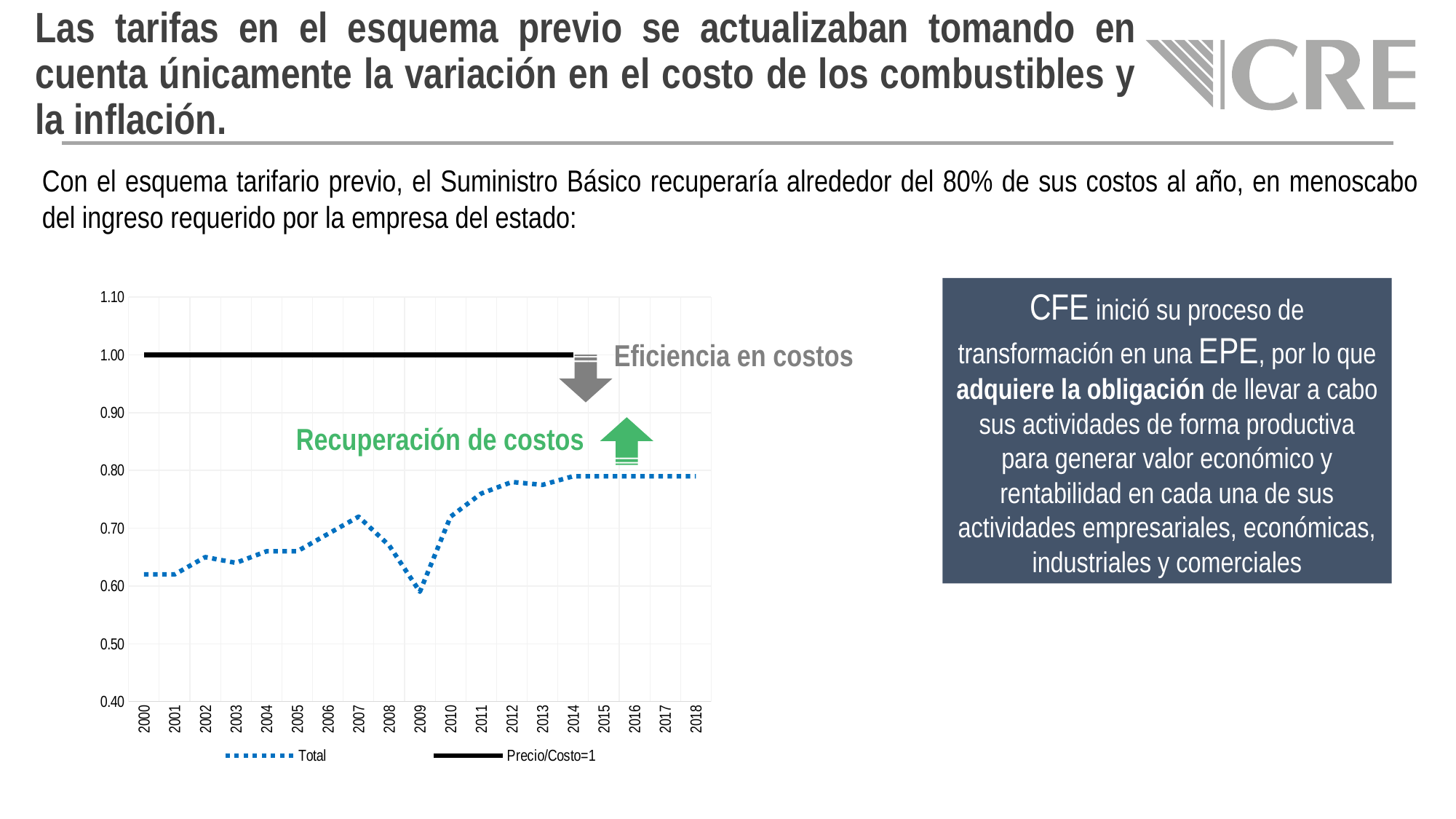
Is the value of the Total series in 2000 greater or less than 0.70? less Is the value of the Total series in 2009 greater or less than 0.70? less Which is larger for the Total series: the value in 2000 or the value in 2018? 2018 How many years are shown on the x axis of the chart? 19 Which is larger for the Total series: the value in 2007 or the value in 2009? 2007 What are the two series named in the chart legend? Total and Precio/Costo=1 Is the value of the Total series in 2018 greater or less than 0.70? greater In which year does the Total series reach its lowest value? 2009 How many series does the chart legend list? 2 Overall, does the Total series rise or fall from 2000 to 2018? Rise What kind of chart is shown on the slide? Line chart At what value does the Precio/Costo=1 line sit on the y axis? 1.00